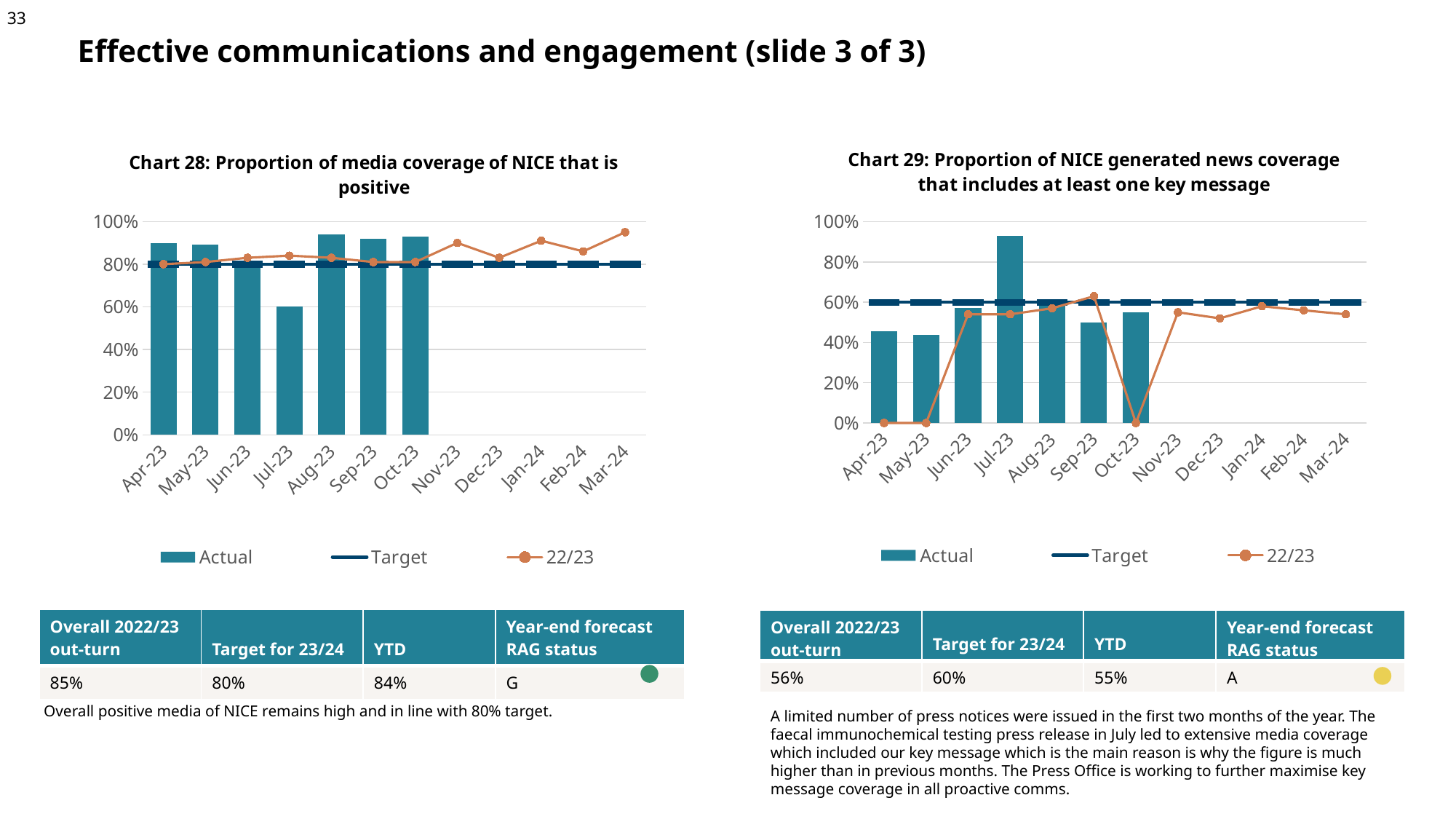
In Chart 28, which month has the lowest Actual bar? Jul-23 In Chart 29, is the Actual value for Apr-23 greater or less than 60%? less In Chart 28, how many series does the legend list? 3 In Chart 29, how many series does the legend list? 3 In Chart 28, is the Actual value for Jul-23 greater or less than 80%? less What kind of chart is Chart 28: Proportion of media coverage of NICE that is positive? bar chart with line series In Chart 29, what is the 22/23 value for Apr-23? 0% In Chart 29, is the Actual value for Jul-23 greater or less than 80%? greater In Chart 29: Proportion of NICE generated news coverage that includes at least one key message, which month has the highest Actual bar? Jul-23 In Chart 28, how many months are shown on the x axis? 12 In Chart 28, which is larger, the Actual bar for Jul-23 or the Actual bar for Oct-23? Oct-23